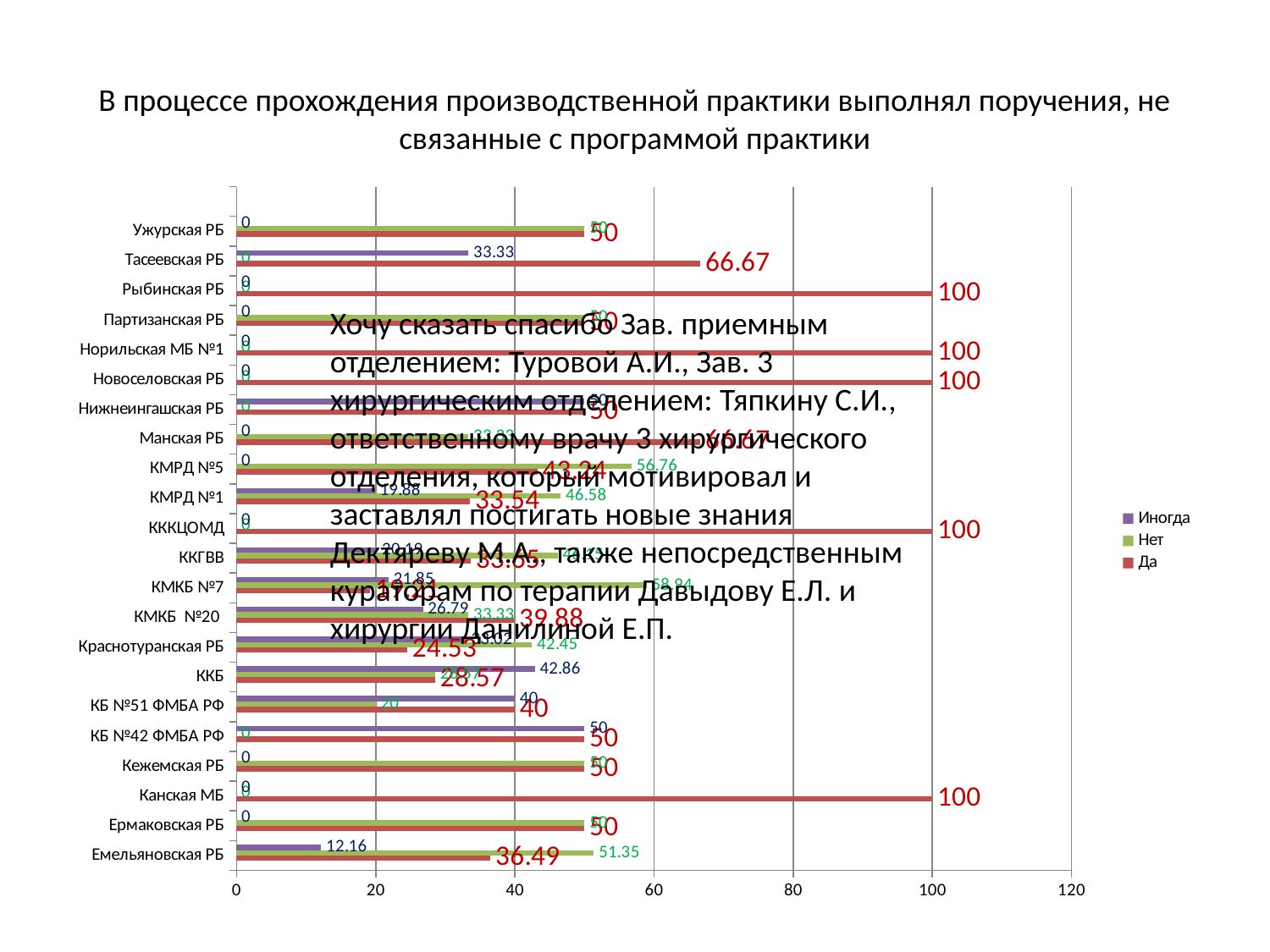
What is the value of the "Нет" series for Емельяновская РБ? 51.35 What is the value of the "Иногда" series for Емельяновская РБ? 12.16 What kind of chart is shown on the slide? bar chart Which series is shown in red in the legend? Да Is the "Да" value for Канская МБ greater or less than 80? greater How many categories (hospitals) are shown on the y axis? 22 What is the value of the "Да" series for КМКБ №20? 39.88 Which is larger for Емельяновская РБ: the "Нет" value or the "Да" value? Нет What is the value of the "Иногда" series for ККБ? 42.86 What is the value of the "Да" series for Тасеевская РБ? 66.67 How many series does the legend list? 3 What is the difference between the "Да" value for Тасеевская РБ and the "Иногда" value for Тасеевская РБ? 33.34